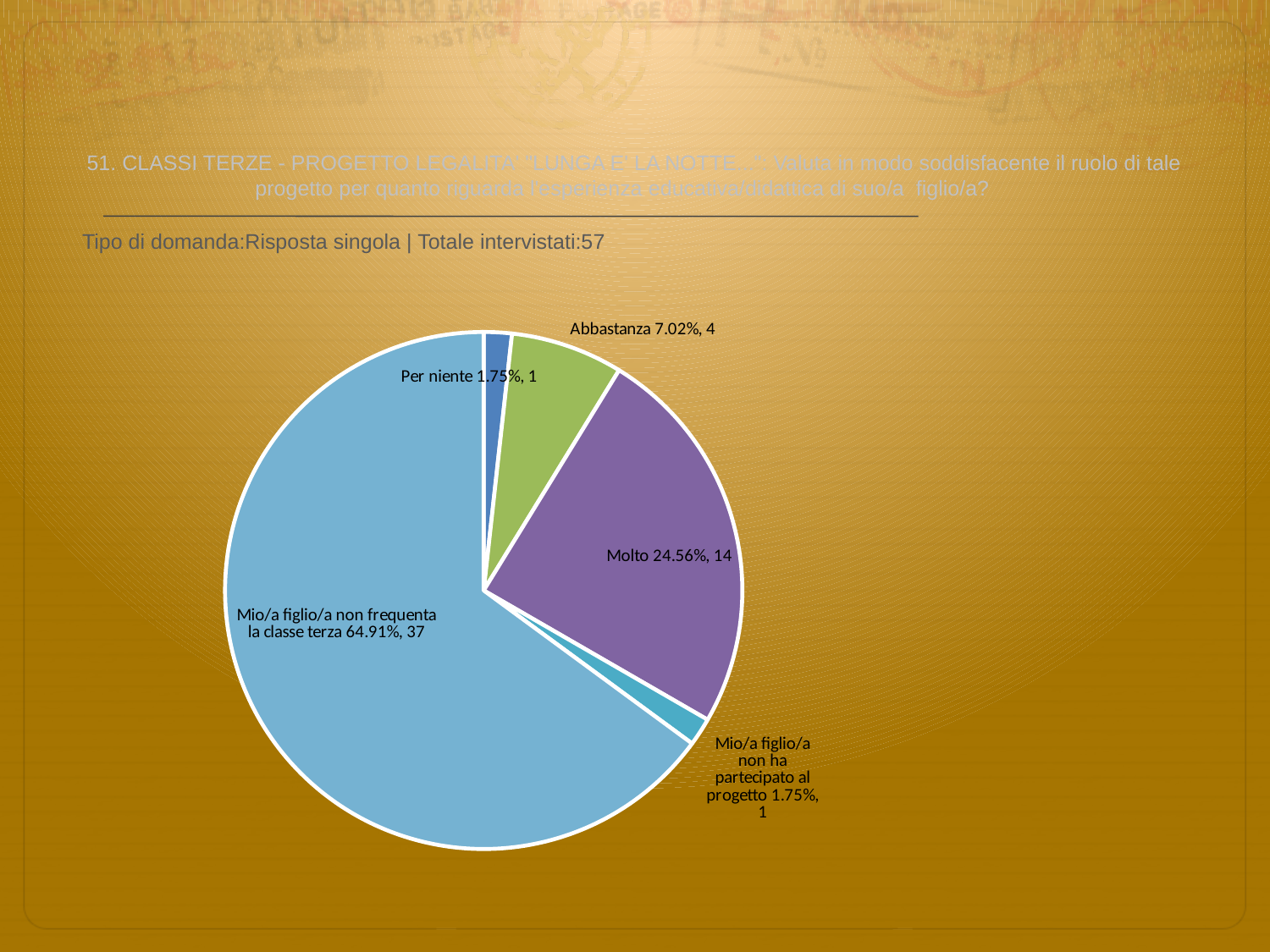
What is the total number of respondents stated on the slide? 57 How many respondents answered "Per niente"? 1 How many respondents answered "Molto"? 14 What is the difference in respondent count between "Molto" and "Abbastanza"? 10 Which category has the largest slice of the pie? Mio/a figlio/a non frequenta la classe terza What kind of chart is shown on the slide? pie chart Which is larger, the "Abbastanza" slice or the "Molto" slice? Molto What percentage share does the "Mio/a figlio/a non frequenta la classe terza" slice have? 64.91% How many respondents answered "Abbastanza"? 4 What percentage share does the "Mio/a figlio/a non ha partecipato al progetto" slice have? 1.75% What percentage share does the "Molto" slice have? 24.56% How many slices does the pie chart have? 5